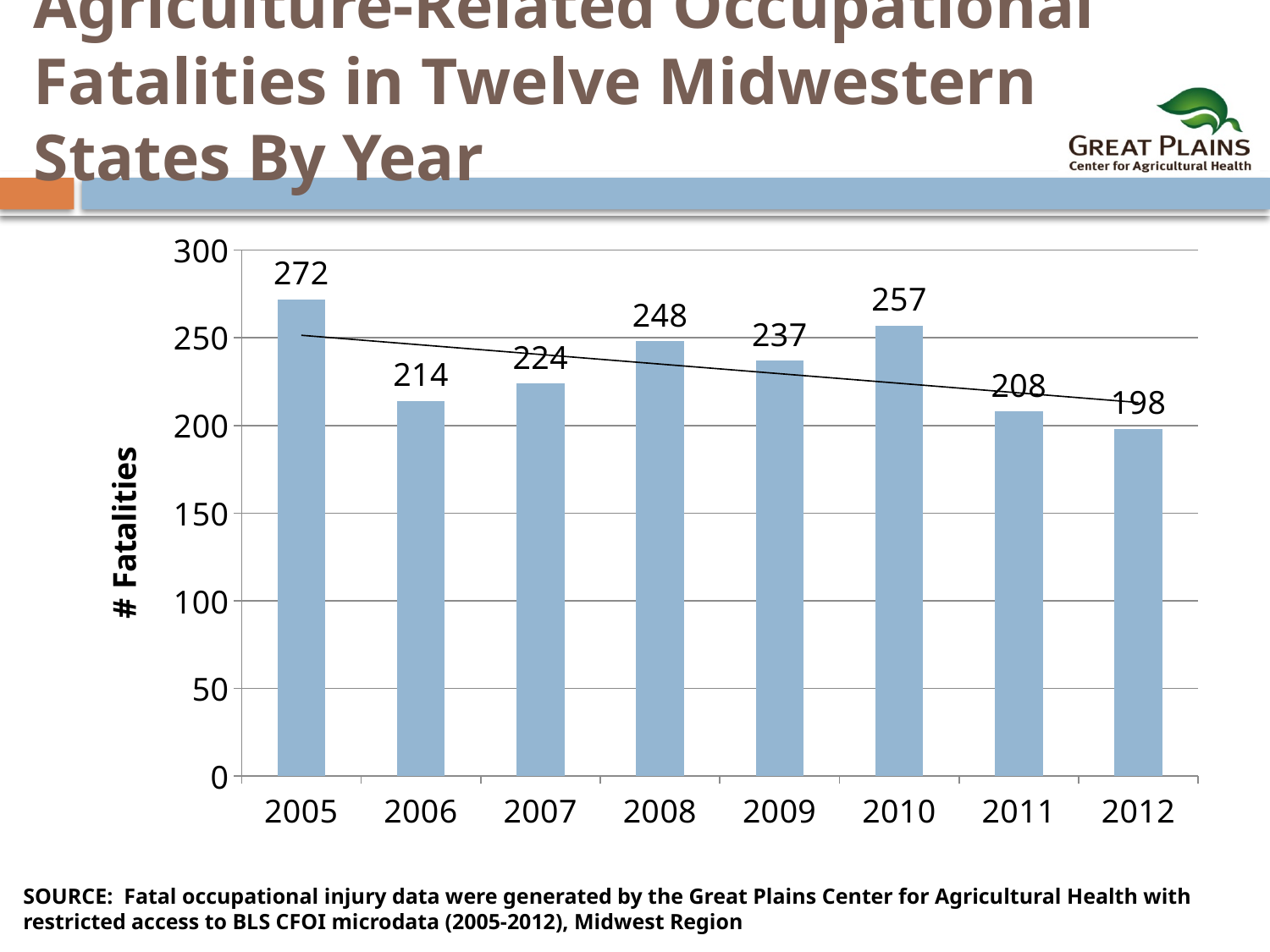
What is the number of fatalities in 2010? 257 Which year had more fatalities, 2008 or 2009? 2008 What kind of chart is shown on the slide? bar chart What is the difference in fatalities between 2010 and 2011? 49 What is the number of fatalities in 2012? 198 What is the label of the vertical axis? # Fatalities Which year has the highest number of fatalities? 2005 Is the value for 2006 greater or less than 250? less Which year has the lowest number of fatalities? 2012 How many years are shown on the x axis? 8 What is the number of fatalities in 2005? 272 What is the difference in fatalities between 2005 and 2012? 74